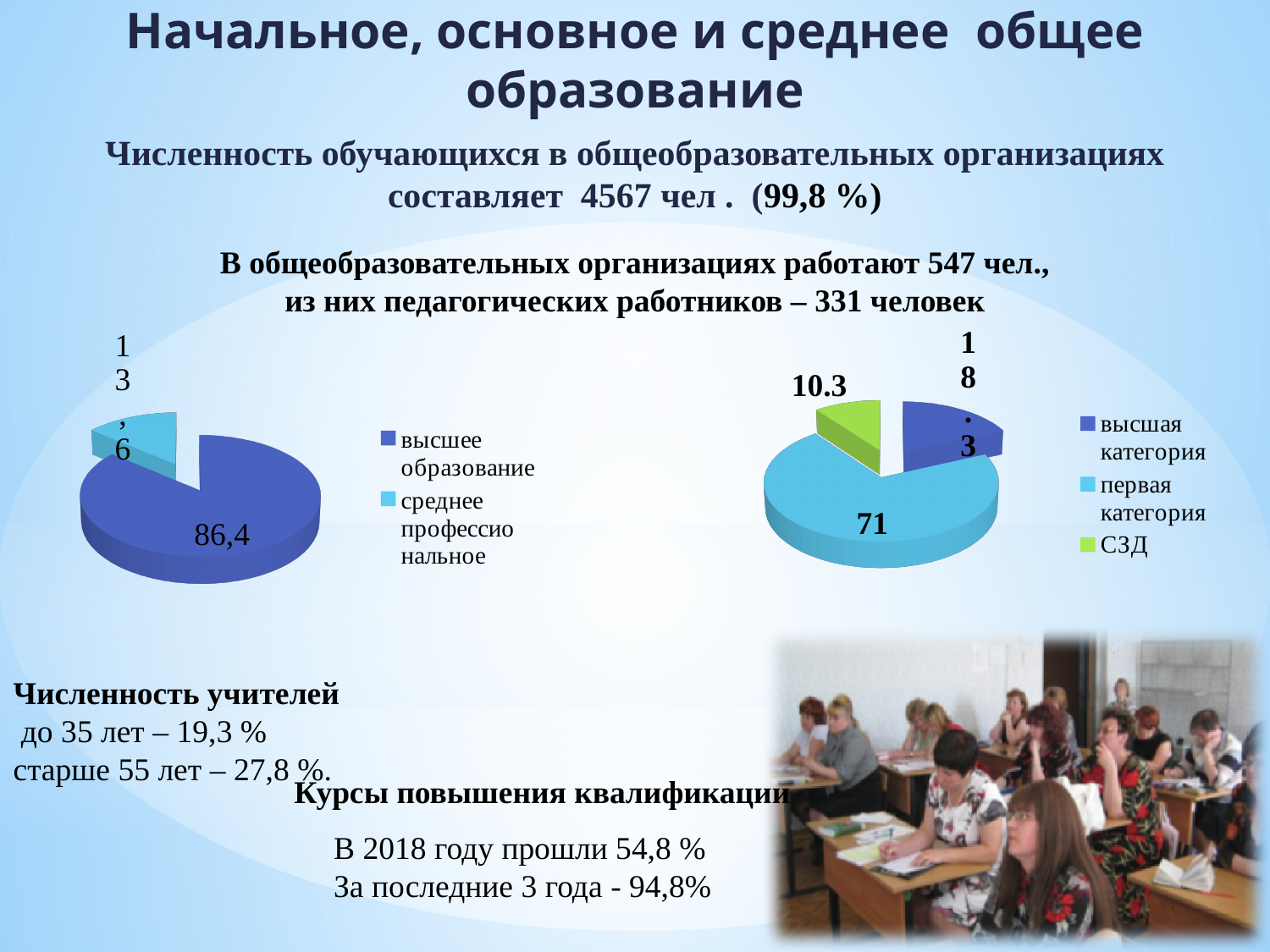
On the right pie chart, how many categories does the legend list? 3 On the right pie chart, what is the value for первая категория? 71 On the left pie chart, which category has the largest slice? высшее образование On the left pie chart, what is the value for высшее образование? 86,4 On the right pie chart, what is the difference between первая категория and высшая категория? 52.7 On the right pie chart, which is larger: высшая категория or СЗД? высшая категория On the right pie chart, what is the value for СЗД? 10.3 On the left pie chart, how many categories does the legend list? 2 On the right pie chart, what is the value for высшая категория? 18.3 What kind of chart is the left chart? pie chart On the left pie chart, what is the value for среднее профессиональное? 13,6 On the right pie chart, which category has the smallest slice? СЗД